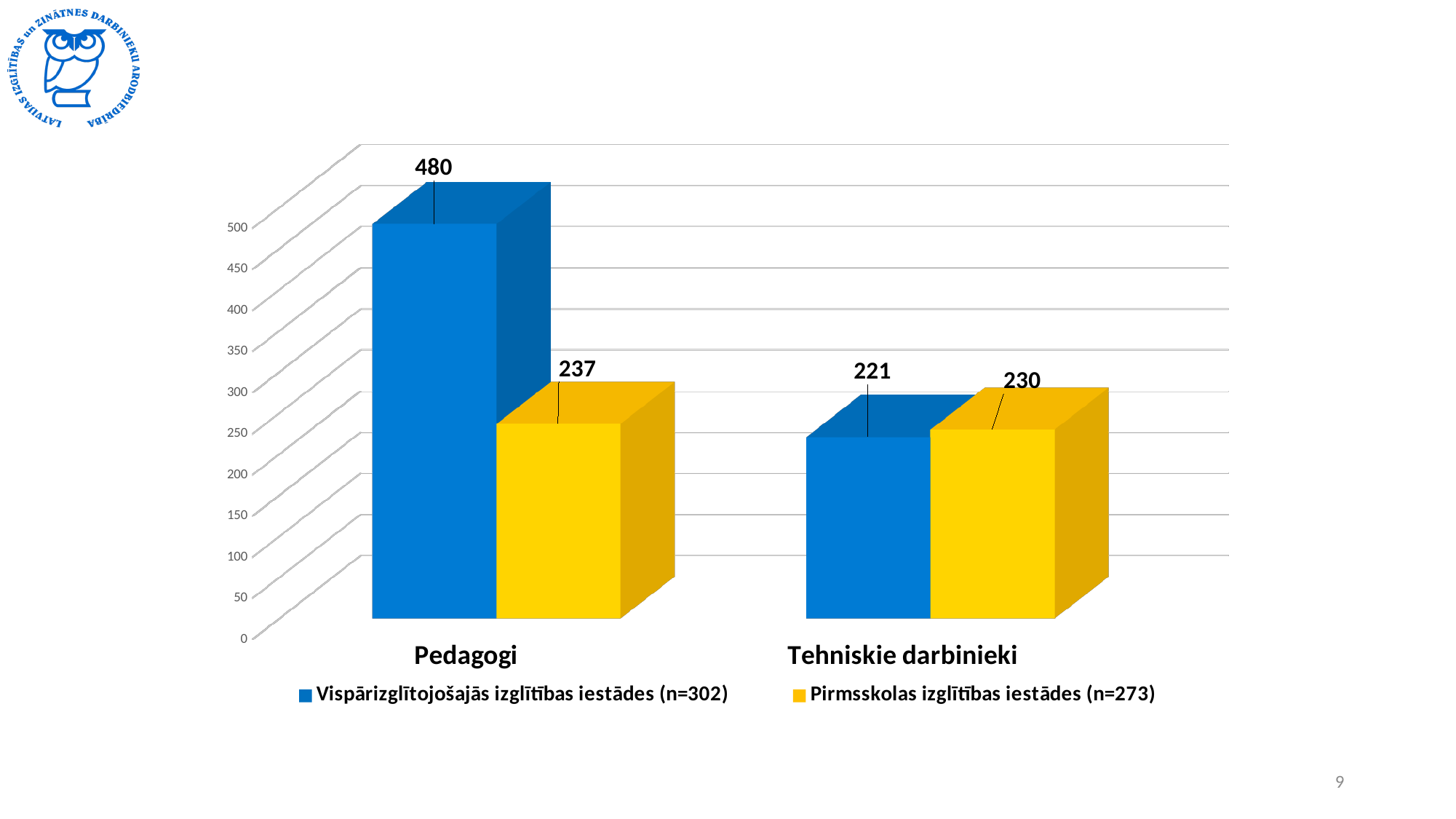
For Tehniskie darbinieki, which series has the larger value? Pirmsskolas izglītības iestādes (n=273) What is the difference between the Pedagogi and Tehniskie darbinieki values in the Vispārizglītojošajās izglītības iestādes (n=302) series? 259 What is the difference between the two series' values for Pedagogi? 243 What kind of chart is shown on the slide? Bar chart What is the value for Tehniskie darbinieki in the Pirmsskolas izglītības iestādes (n=273) series? 230 Which category has the highest value in the Vispārizglītojošajās izglītības iestādes (n=302) series? Pedagogi How many series does the legend list? 2 What is the value for Pedagogi in the Vispārizglītojošajās izglītības iestādes (n=302) series? 480 Which category has the lowest value in the Pirmsskolas izglītības iestādes (n=273) series? Tehniskie darbinieki What is the value for Pedagogi in the Pirmsskolas izglītības iestādes (n=273) series? 237 How many categories are shown on the x axis? 2 What is the value for Tehniskie darbinieki in the Vispārizglītojošajās izglītības iestādes (n=302) series? 221